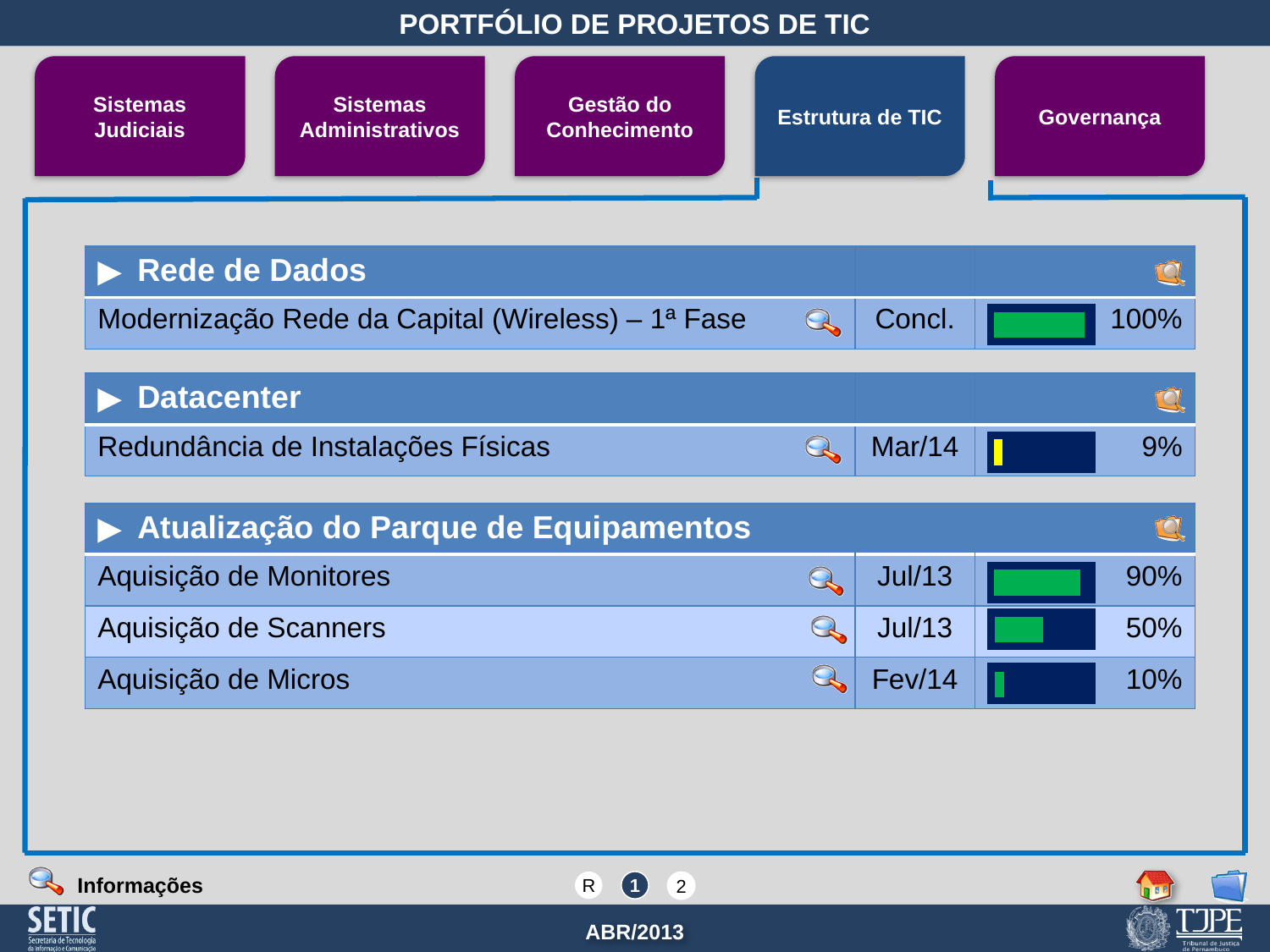
What is the progress percentage shown for Aquisição de Micros? 10% What is the difference in progress percentage between Aquisição de Monitores and Aquisição de Scanners? 40% What is the progress percentage shown for Modernização Rede da Capital (Wireless) – 1ª Fase? 100% What is the deadline shown for Aquisição de Micros? Fev/14 Which project has the highest progress percentage on the slide? Modernização Rede da Capital (Wireless) – 1ª Fase What is the progress percentage shown for Redundância de Instalações Físicas? 9% What is the progress percentage shown for Aquisição de Scanners? 50% What colour is the progress bar fill for Redundância de Instalações Físicas? Yellow What is the progress percentage shown for Aquisição de Monitores? 90% Which project has the lowest progress percentage on the slide? Redundância de Instalações Físicas Which has a higher progress percentage, Aquisição de Micros or Aquisição de Scanners? Aquisição de Scanners How many projects with progress bars are listed on the slide? 5